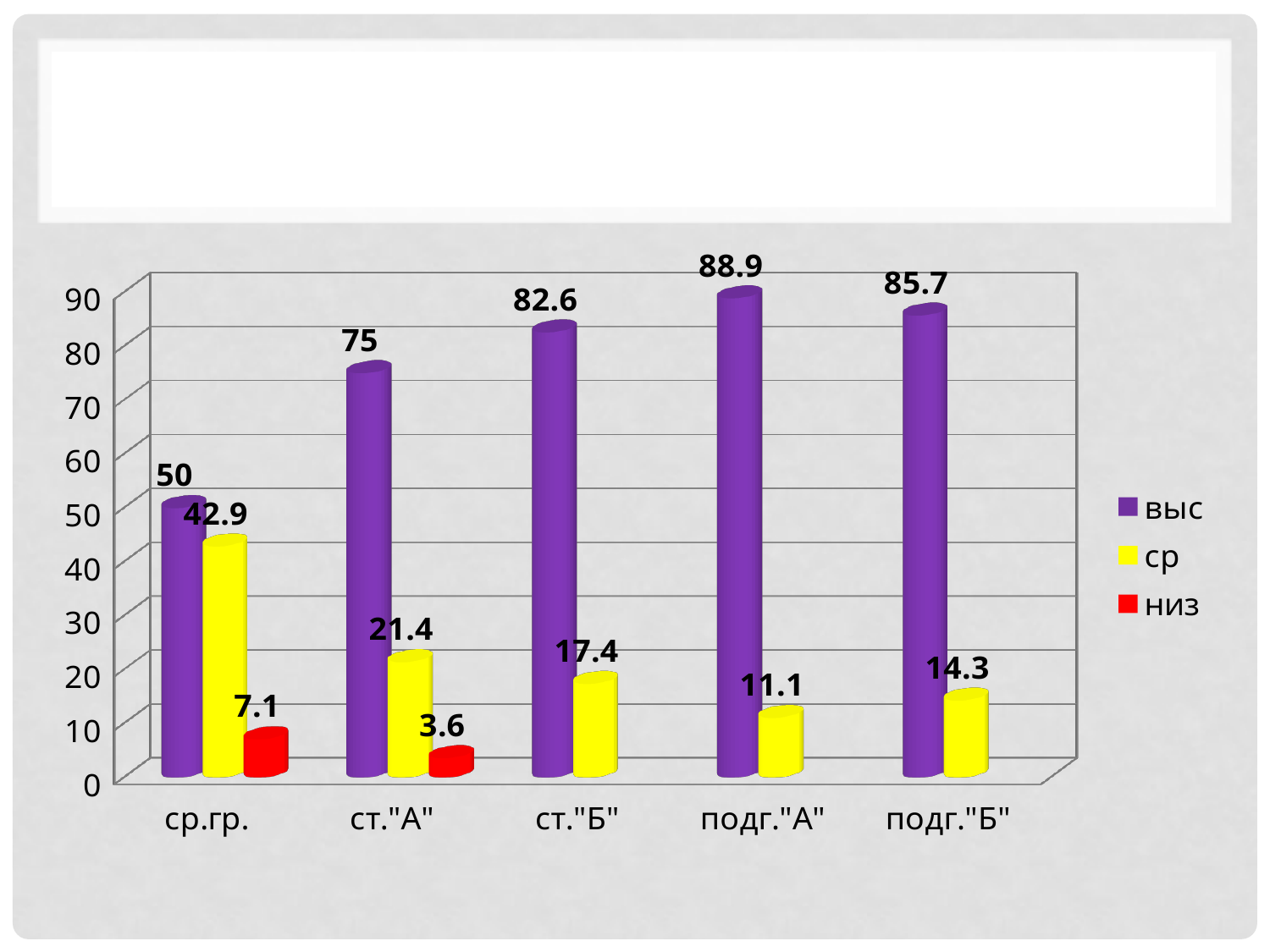
What is the value of the "низ" series for ст."А"? 3.6 Which is larger: the "выс" value for подг."Б" or for ст."Б"? подг."Б" Is the "ср" value for ст."А" greater or less than 30? less What colour are the bars for the "низ" series? red What is the difference between the "выс" values for ст."Б" and ст."А"? 7.6 How many categories are shown on the x axis? 5 What is the value of the "выс" series for подг."А"? 88.9 Which category has the highest value in the "выс" series? подг."А" Which category has the lowest value in the "ср" series? подг."А" What is the value of the "ср" series for ср.гр.? 42.9 How many series does the legend list? 3 What kind of chart is shown on the slide? bar chart